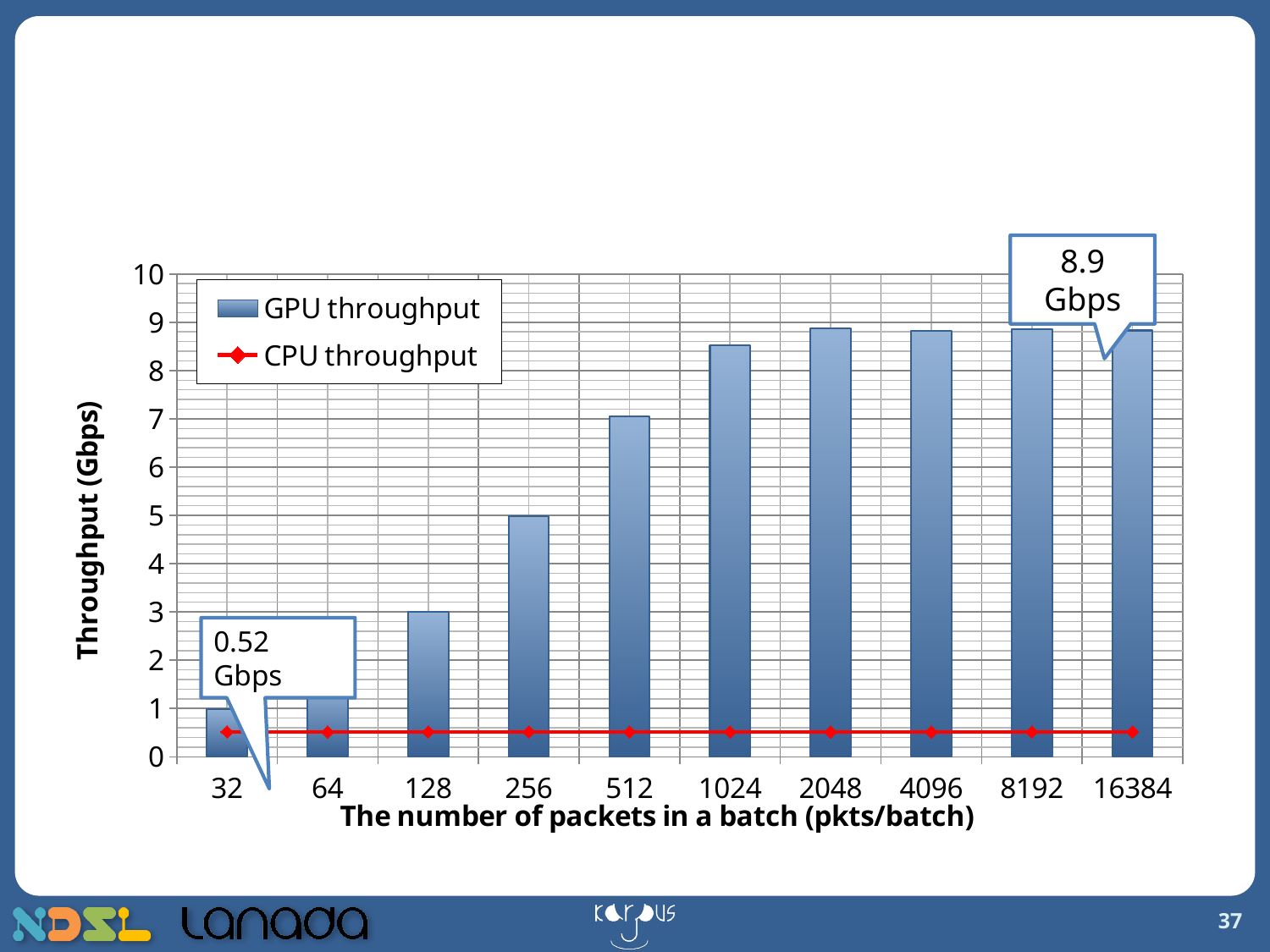
Which batch size has the lowest GPU throughput? 32 How many series does the legend list? 2 Is the GPU throughput for 256 packets per batch greater or less than 4? greater Which has the higher GPU throughput, 256 or 1024 packets per batch? 1024 What is the CPU throughput at 32 packets per batch, as shown by the callout? 0.52 Gbps Is the GPU throughput for 512 packets per batch greater or less than 6? greater Does GPU throughput generally rise or fall as the number of packets in a batch increases? rise Is the GPU throughput for 128 packets per batch greater or less than 4? less How many batch-size categories are shown on the x axis? 10 What is the title of the x axis? The number of packets in a batch (pkts/batch) At 2048 packets per batch, which is higher, GPU throughput or CPU throughput? GPU throughput What kind of chart is shown on the slide? combination bar and line chart